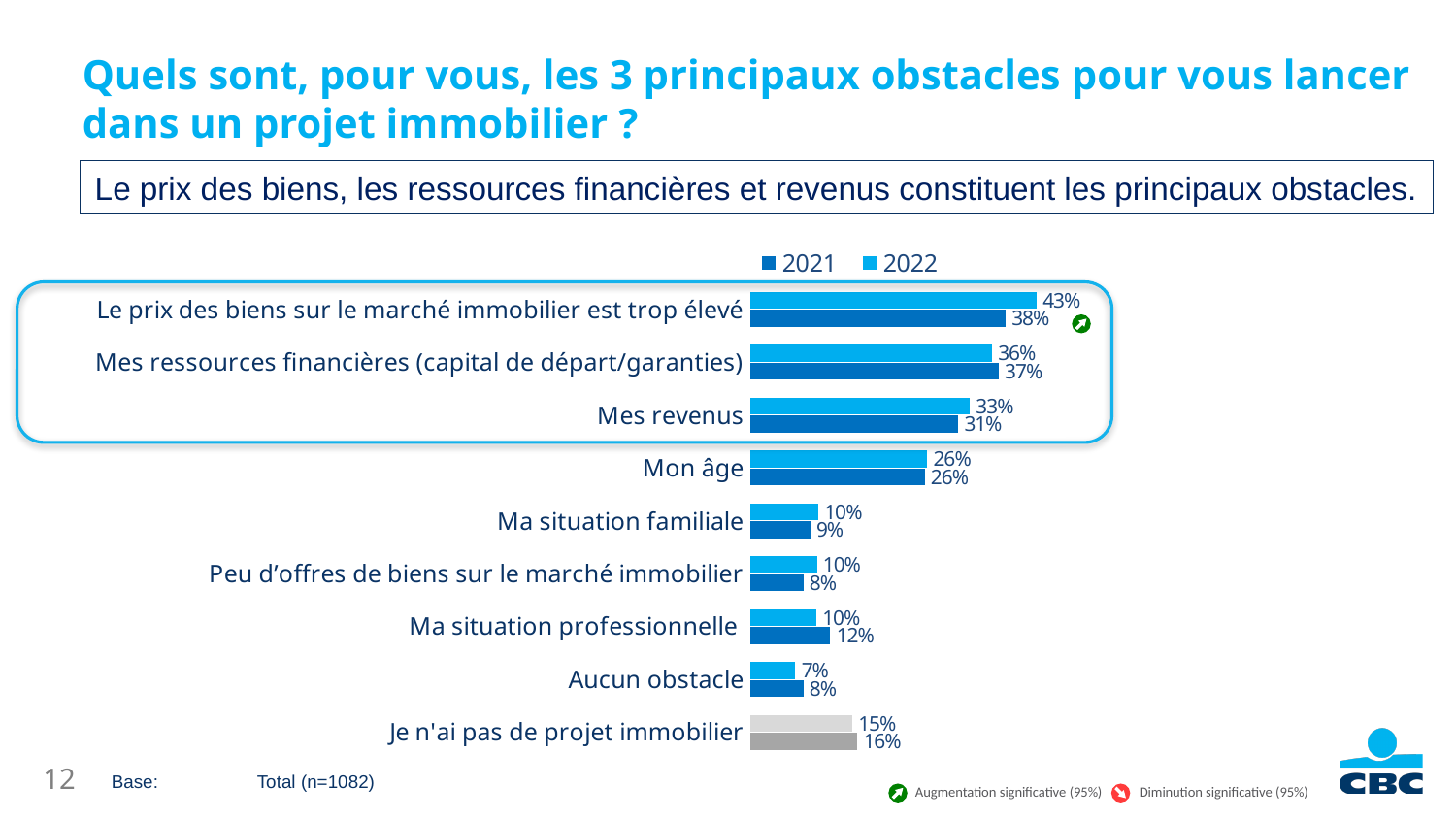
How many series does the legend list? 2 What is the 2021 value for 'Mes ressources financières (capital de départ/garanties)'? 37% Which category has the highest 2022 value? Le prix des biens sur le marché immobilier est trop élevé What type of chart is shown on the slide? bar chart What is the difference between the 2022 and 2021 values for 'Le prix des biens sur le marché immobilier est trop élevé'? 5% Which category has the lowest 2022 value? Aucun obstacle What is the 2022 value for 'Mes revenus'? 33% What is the 2022 value for 'Le prix des biens sur le marché immobilier est trop élevé'? 43% Which is larger for 'Mes revenus': the 2021 value or the 2022 value? 2022 What is the 2021 value for 'Le prix des biens sur le marché immobilier est trop élevé'? 38% What is the 2021 value for 'Ma situation professionnelle'? 12% How many categories (obstacles) are shown in the chart? 9